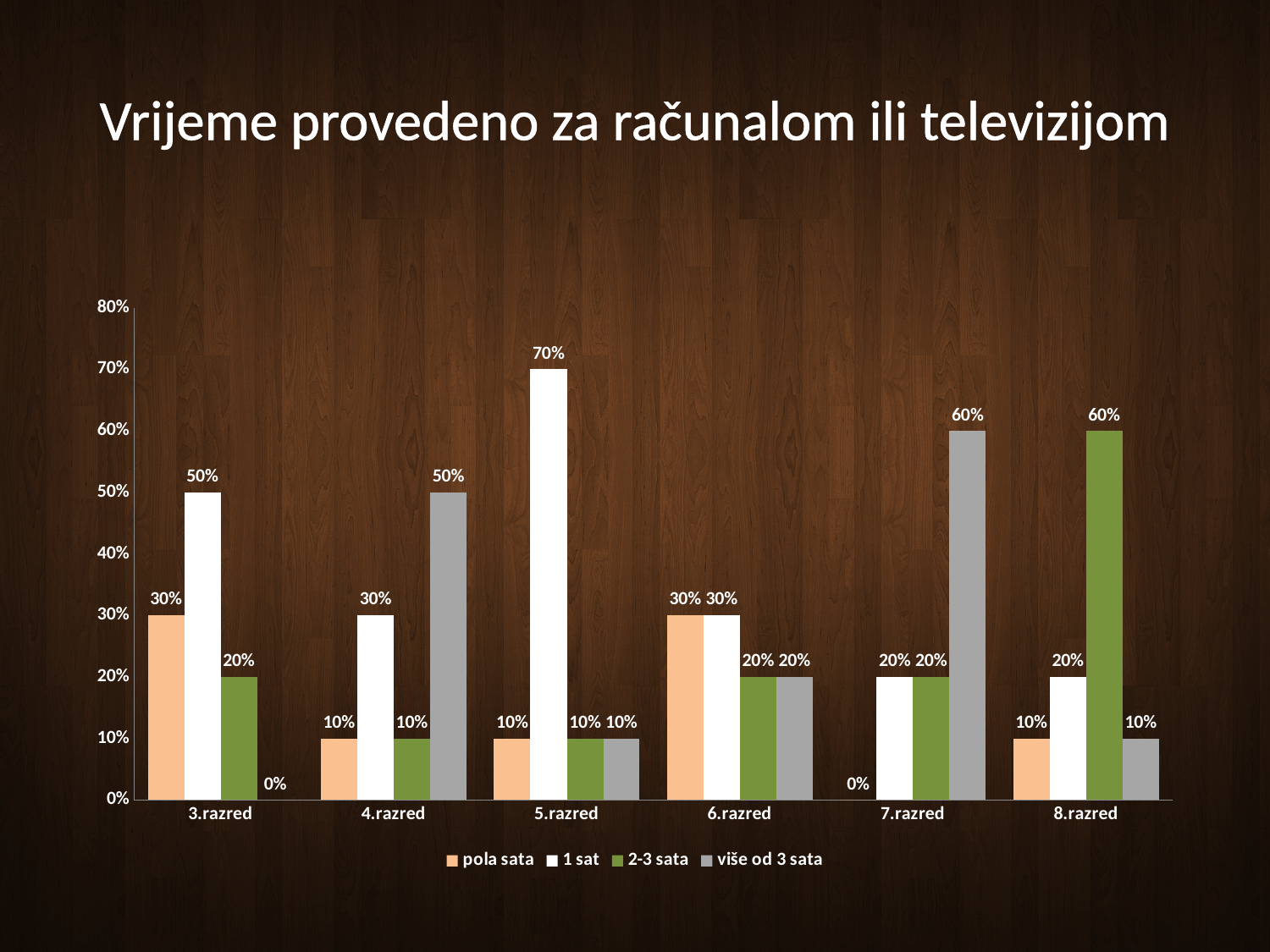
Which category has the lowest value for "pola sata"? 7.razred In 6.razred, which is larger: the value for "pola sata" or the value for "2-3 sata"? pola sata What is the value for "pola sata" in 3.razred? 30% How many categories are shown on the x axis? 6 How many series does the legend list? 4 What kind of chart is shown on the slide? Bar chart What is the value for "1 sat" in 5.razred? 70% What is the value for "2-3 sata" in 8.razred? 60% Which category has the highest value for "1 sat"? 5.razred What is the value for "više od 3 sata" in 7.razred? 60% What is the title of the chart? Vrijeme provedeno za računalom ili televizijom What is the difference between the "1 sat" value and the "pola sata" value in 4.razred? 20%